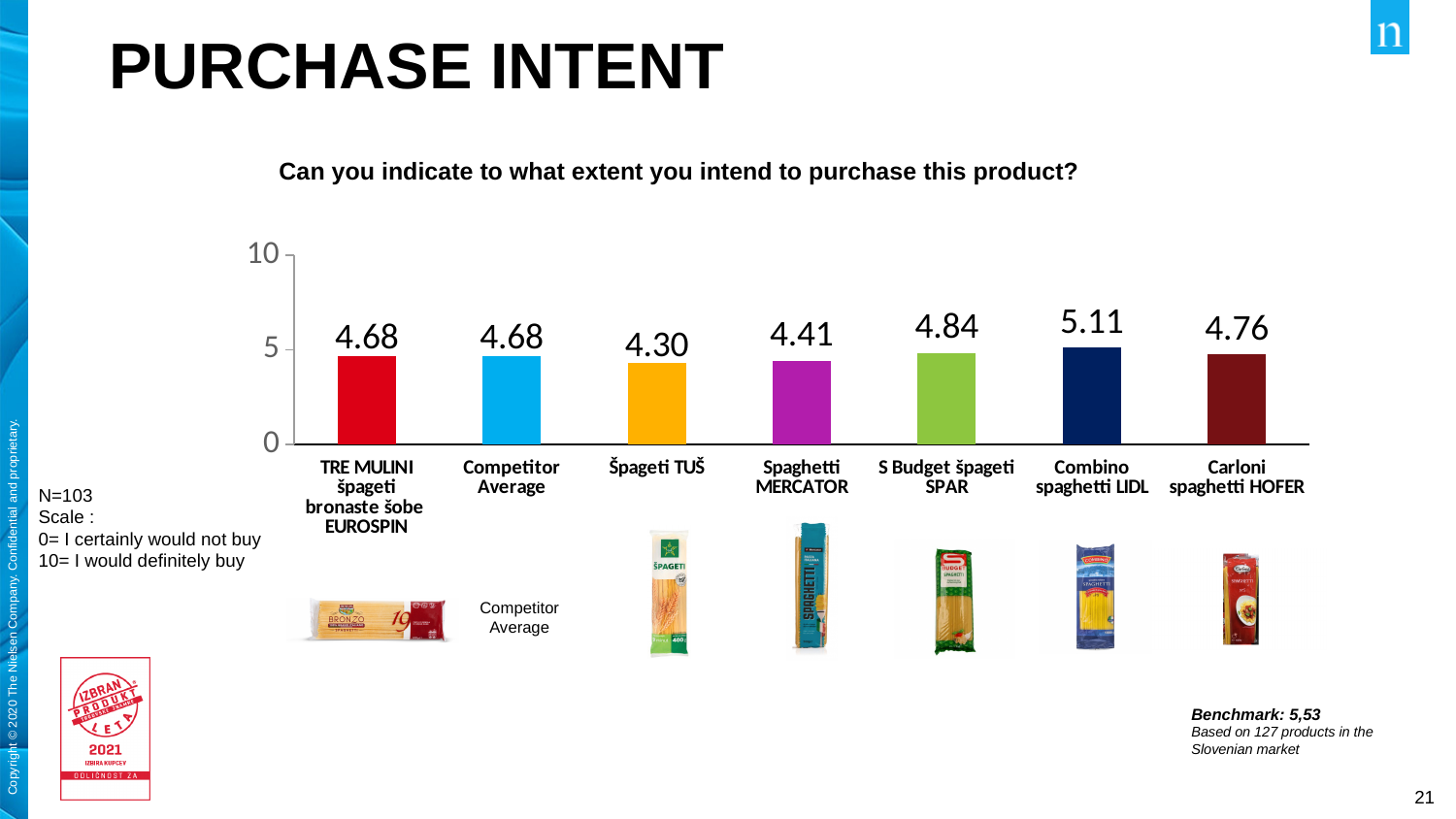
Which product has the lowest purchase intent value? Špageti TUŠ Which has a higher value: Carloni spaghetti HOFER or Spaghetti MERCATOR? Carloni spaghetti HOFER How many bars are shown in the chart? 7 What is the purchase intent value for Combino spaghetti LIDL? 5.11 What is the benchmark value stated on the slide? 5,53 Which product has the highest purchase intent value? Combino spaghetti LIDL What is the value shown for the Competitor Average? 4.68 What type of chart is shown on the slide? Bar chart What is the purchase intent value for Špageti TUŠ? 4.30 What is the purchase intent value for S Budget špageti SPAR? 4.84 Is the value for Combino spaghetti LIDL greater or less than 5? greater What is the difference between the values for Combino spaghetti LIDL and Špageti TUŠ? 0.81